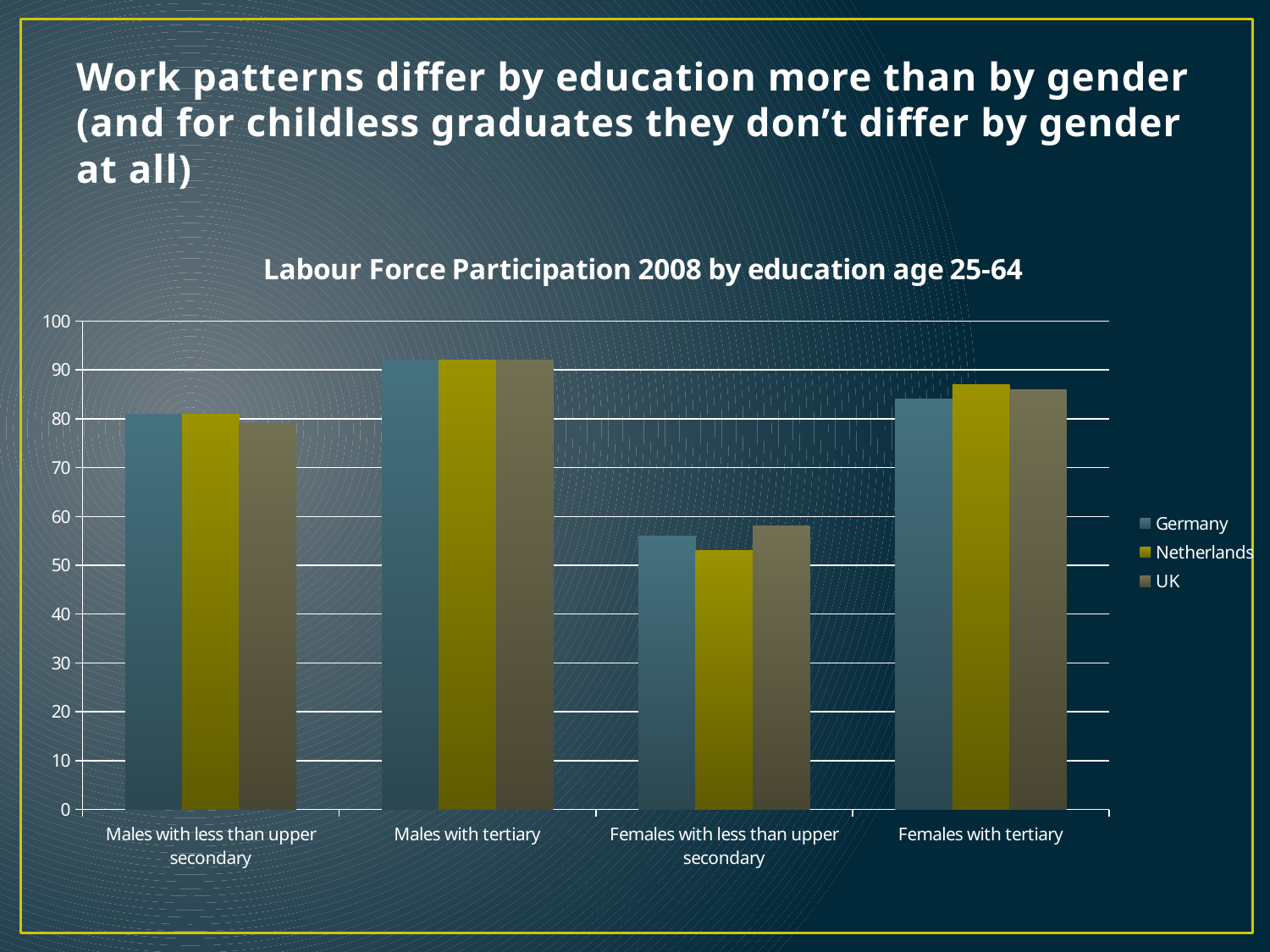
How many categories are shown on the x axis? 4 What is the title of the chart? Labour Force Participation 2008 by education age 25-64 What kind of chart is shown on the slide? bar chart Is the UK value for Females with tertiary greater or less than 80? greater Which countries are listed in the legend? Germany, Netherlands, UK Is the Netherlands value for Males with tertiary greater or less than 80? greater How many series does the legend list? 3 Is the Germany value for Females with less than upper secondary greater or less than 60? less For the UK, which category has the lowest value? Females with less than upper secondary For Germany, which category has the highest labour force participation? Males with tertiary For Germany, which category has the lowest labour force participation? Females with less than upper secondary Which is larger for Germany: Males with tertiary or Females with tertiary? Males with tertiary